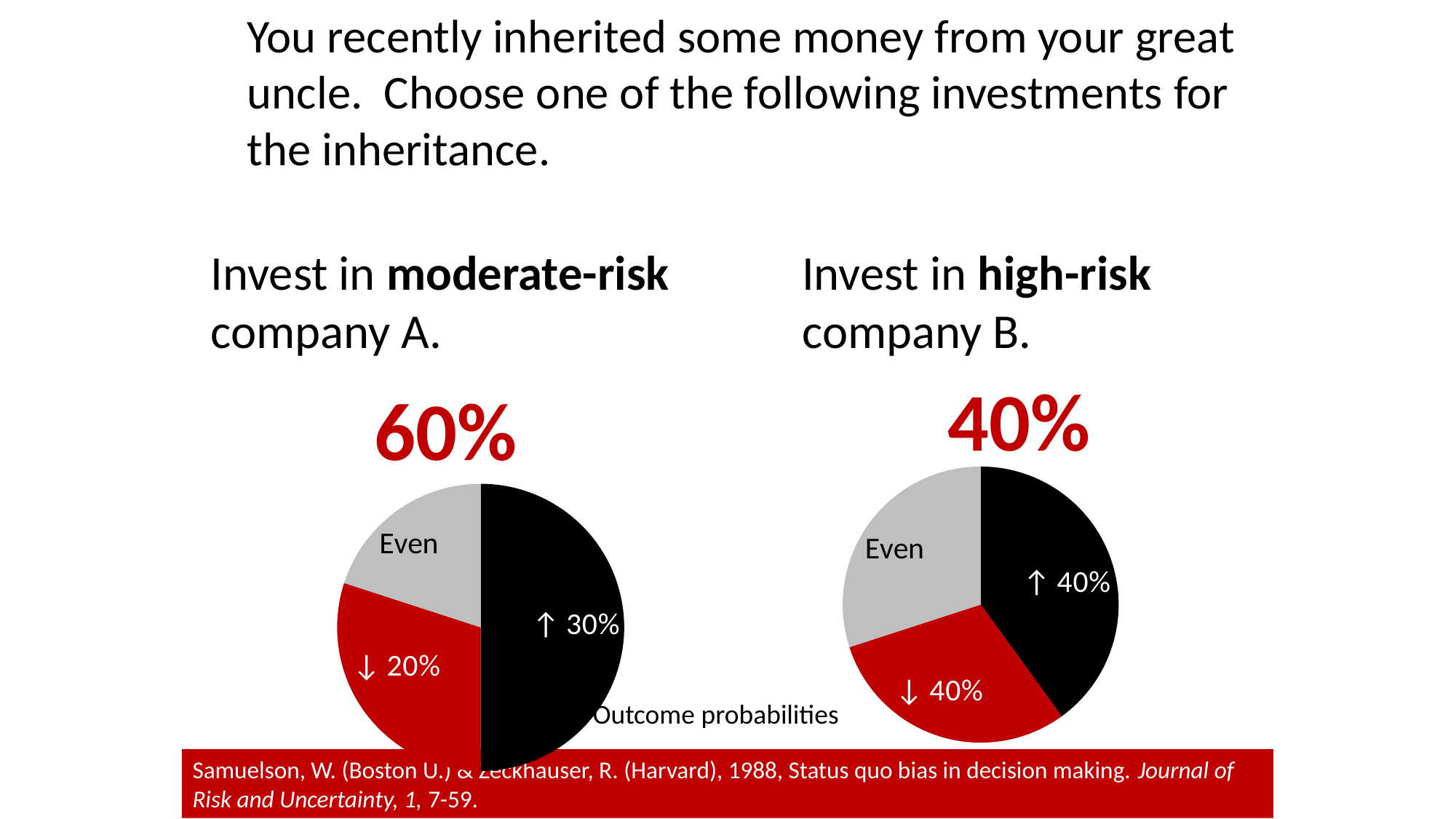
How many slices does the pie chart for high-risk company B have? 3 What colour is the slice for the down (↓) outcome in both pie charts? red What large red percentage is printed above the pie chart for moderate-risk company A? 60% What kind of chart is used for the moderate-risk company A? pie chart How many slices does the pie chart for moderate-risk company A have? 3 In the pie chart for moderate-risk company A, which is larger, the up (↑) probability or the down (↓) probability? up (↑)